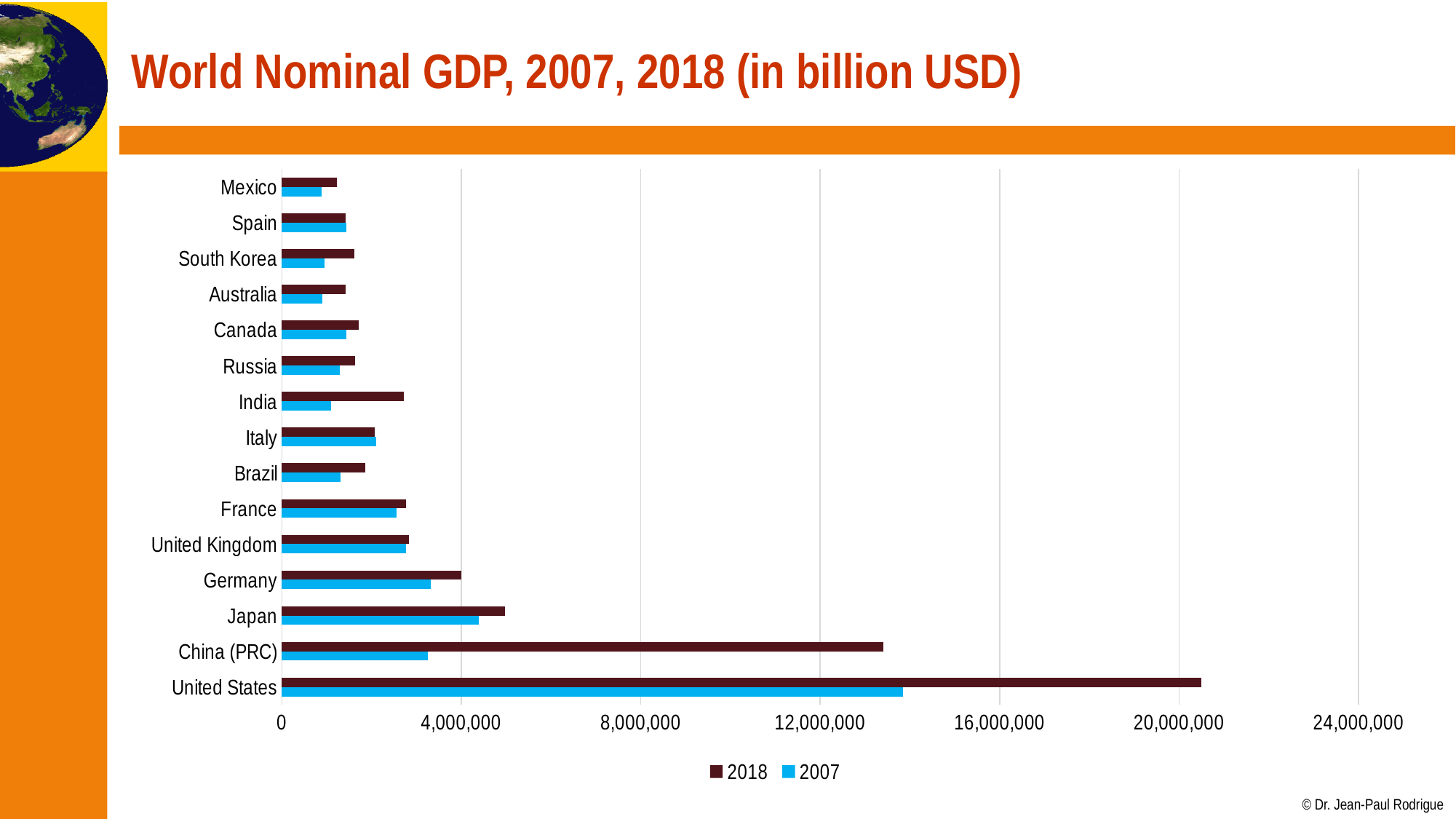
Is the 2018 value for the United States greater or less than 20,000,000? greater What is the title of the chart? World Nominal GDP, 2007, 2018 (in billion USD) Which is larger, the 2018 value for China (PRC) or the 2018 value for Japan? China (PRC) Which country has the highest nominal GDP in 2018? United States Which country has the lowest nominal GDP in 2018? Mexico How many series does the legend list? 2 Which country has the highest nominal GDP in 2007? United States Is the 2018 value for China (PRC) greater or less than 12,000,000? greater Is the 2007 value for the United States greater or less than 16,000,000? less What kind of chart is shown on the slide? bar chart How many countries are listed on the chart? 15